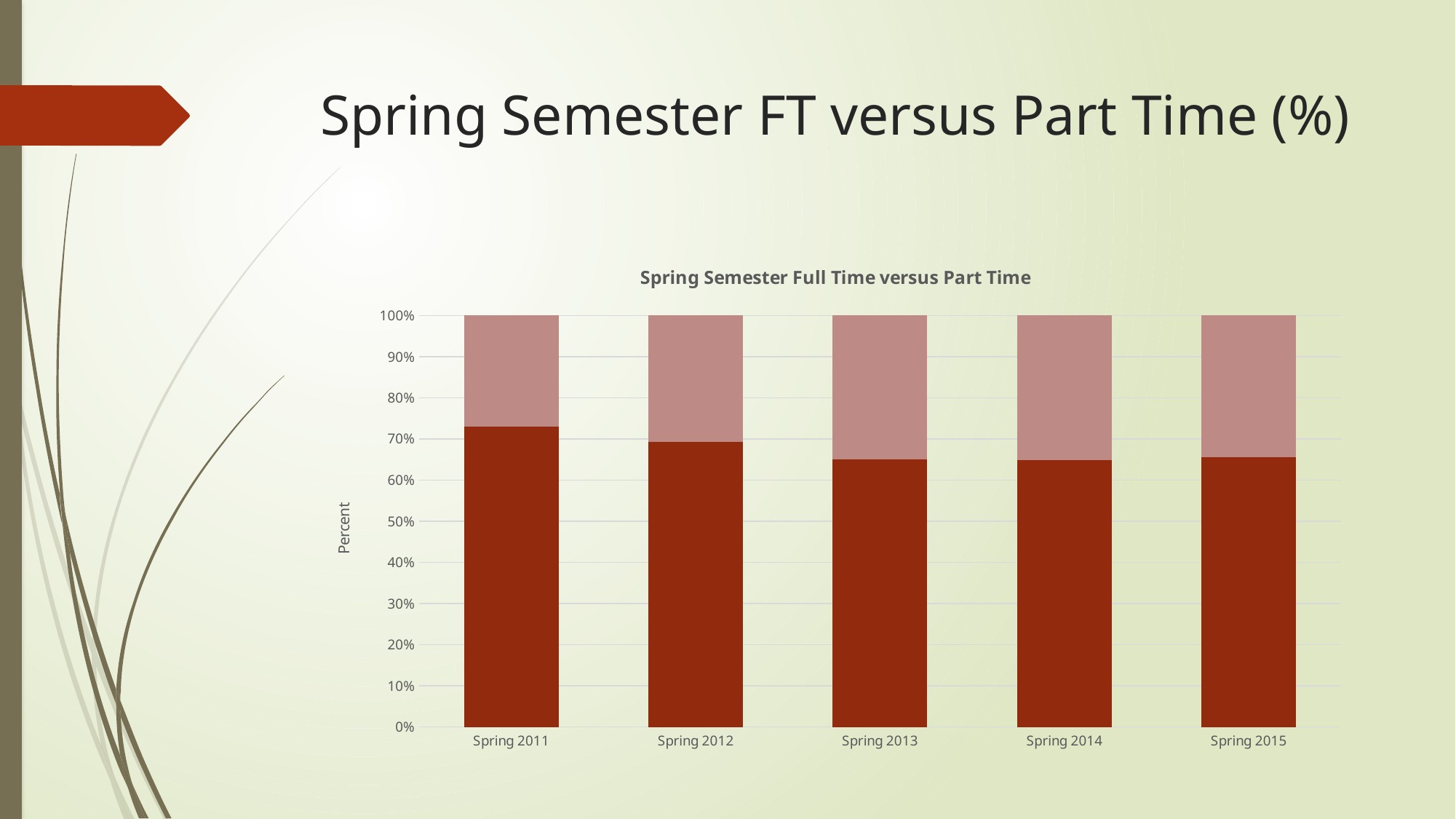
What is the title of the chart? Spring Semester Full Time versus Part Time What is the total height of each stacked bar in the chart? 100% Is the dark red (bottom) segment for Spring 2013 greater or less than 70%? less Which semester has the largest dark red (bottom) segment? Spring 2011 Is the dark red (bottom) segment for Spring 2011 greater or less than 70%? greater What is the label on the vertical axis of the chart? Percent Which has the larger dark red (bottom) segment, Spring 2011 or Spring 2013? Spring 2011 Is the dark red (bottom) segment for Spring 2014 greater or less than 60%? greater How many semesters are shown along the x axis of the chart? 5 Does the dark red (bottom) segment rise or fall from Spring 2011 to Spring 2013? fall Which has the larger dark red (bottom) segment, Spring 2012 or Spring 2015? Spring 2012 What type of chart is shown on the slide? Stacked bar chart